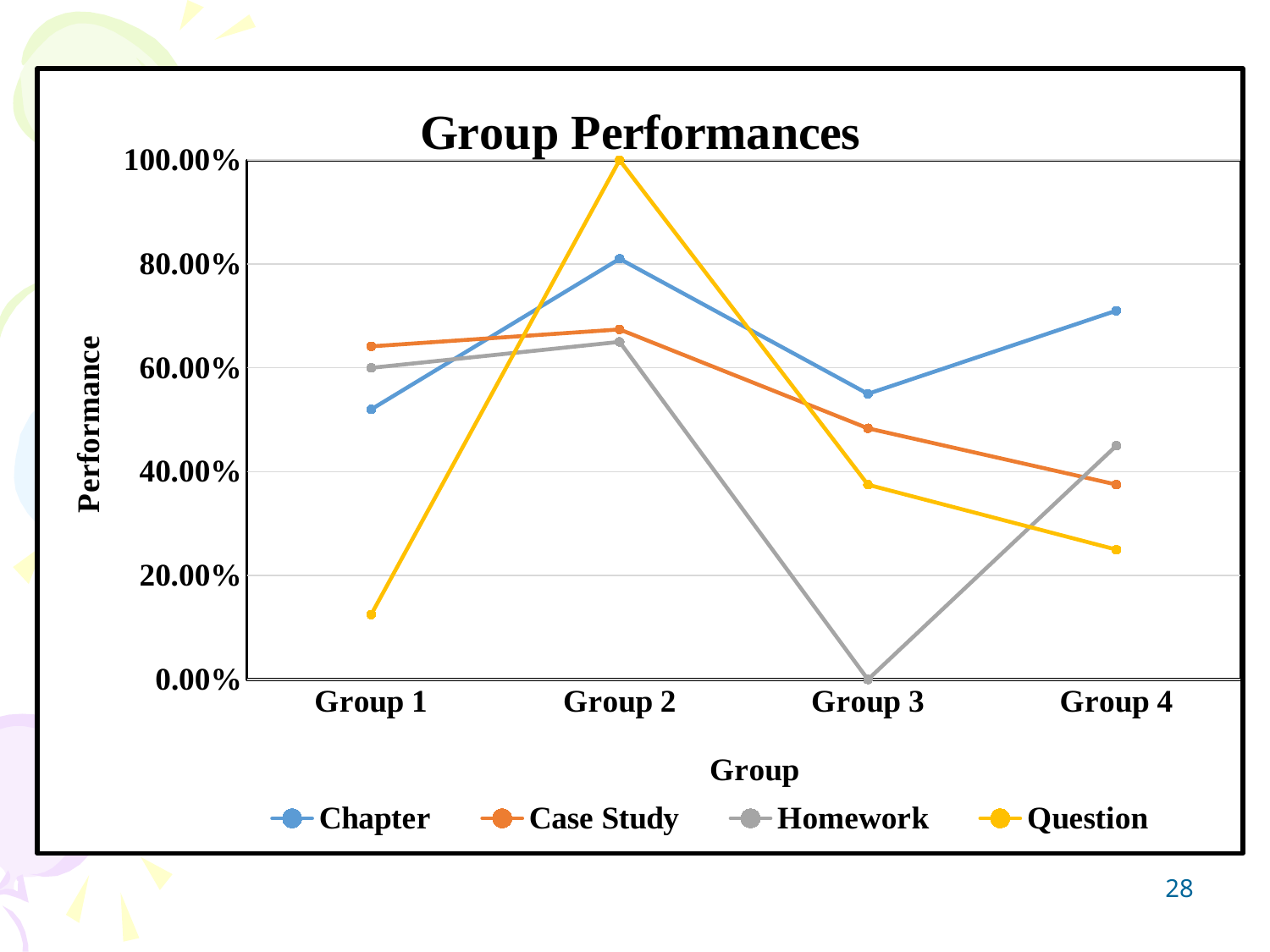
Is the value of the Question series for Group 1 greater or less than 20.00%? less How many series does the legend list? 4 How many groups are shown on the x axis? 4 What is the label of the vertical axis? Performance What is the value of the Question series for Group 2? 100.00% Is the value of the Chapter series for Group 1 greater or less than 40.00%? greater For Group 4, which is larger: the Chapter value or the Question value? Chapter What is the value of the Homework series for Group 3? 0.00% For which group is the Homework series lowest? Group 3 What type of chart is shown on the slide? Line chart For which group is the Question series highest? Group 2 What is the title of the chart? Group Performances